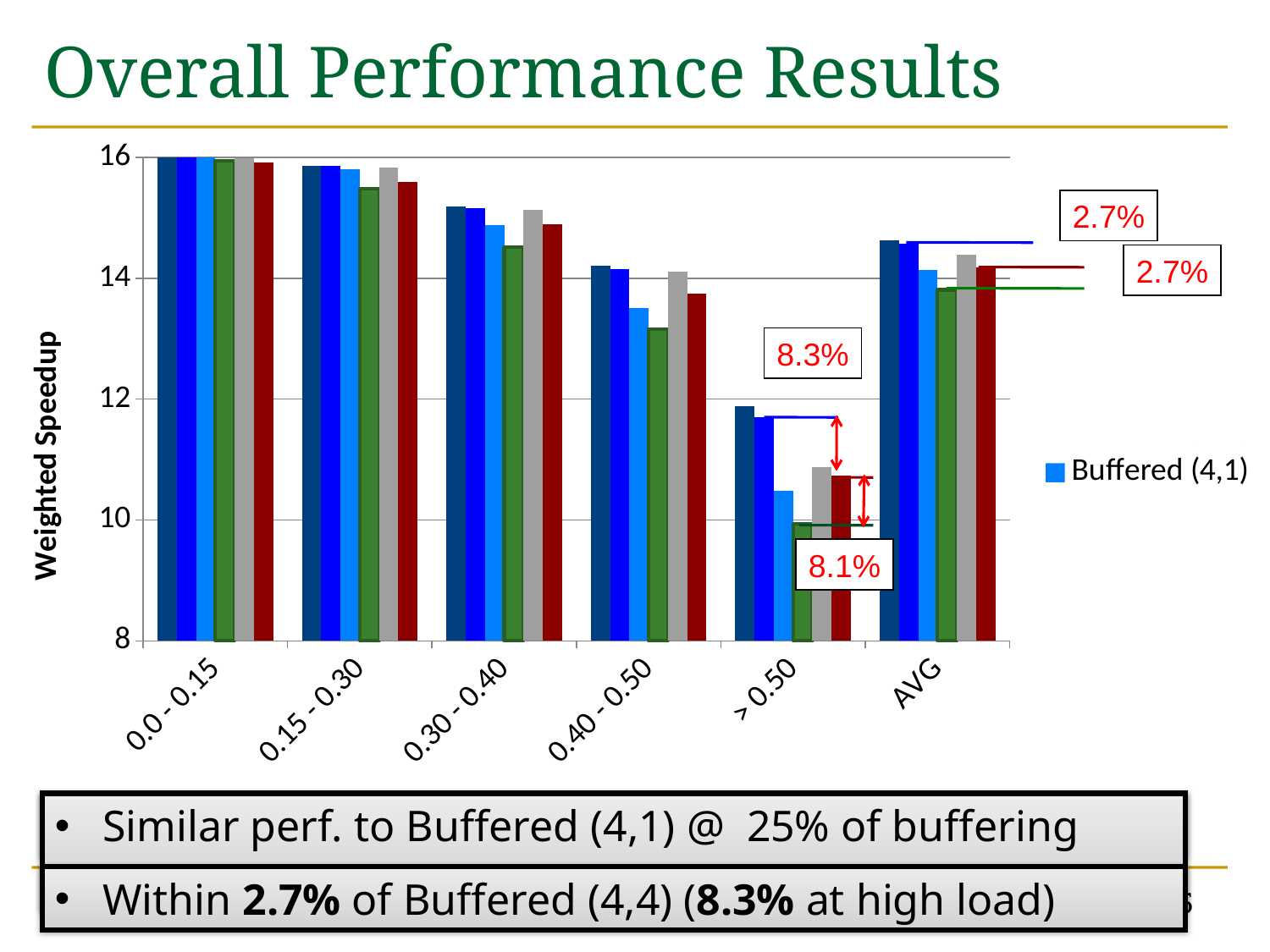
Is the Buffered (4,1) value for the > 0.50 category greater or less than 10? greater Which is larger for the > 0.50 category: the Buffered (4,1) bar or the bar for the 0.0 - 0.15 category of the same series? 0.0 - 0.15 Which series name is readable in the chart's legend? Buffered (4,1) Is the Buffered (4,1) value for the 0.0 - 0.15 category greater or less than 14? greater Which category has the highest bars in the chart? 0.0 - 0.15 How many categories are shown along the x axis of the chart? 6 Do the bar values rise or fall from the 0.0 - 0.15 category to the > 0.50 category? fall Which category has the lowest bars in the chart? > 0.50 Is the Buffered (4,1) value for the 0.40 - 0.50 category greater or less than 14? less What kind of chart is shown on the slide? bar chart What is the title of the y axis of the chart? Weighted Speedup